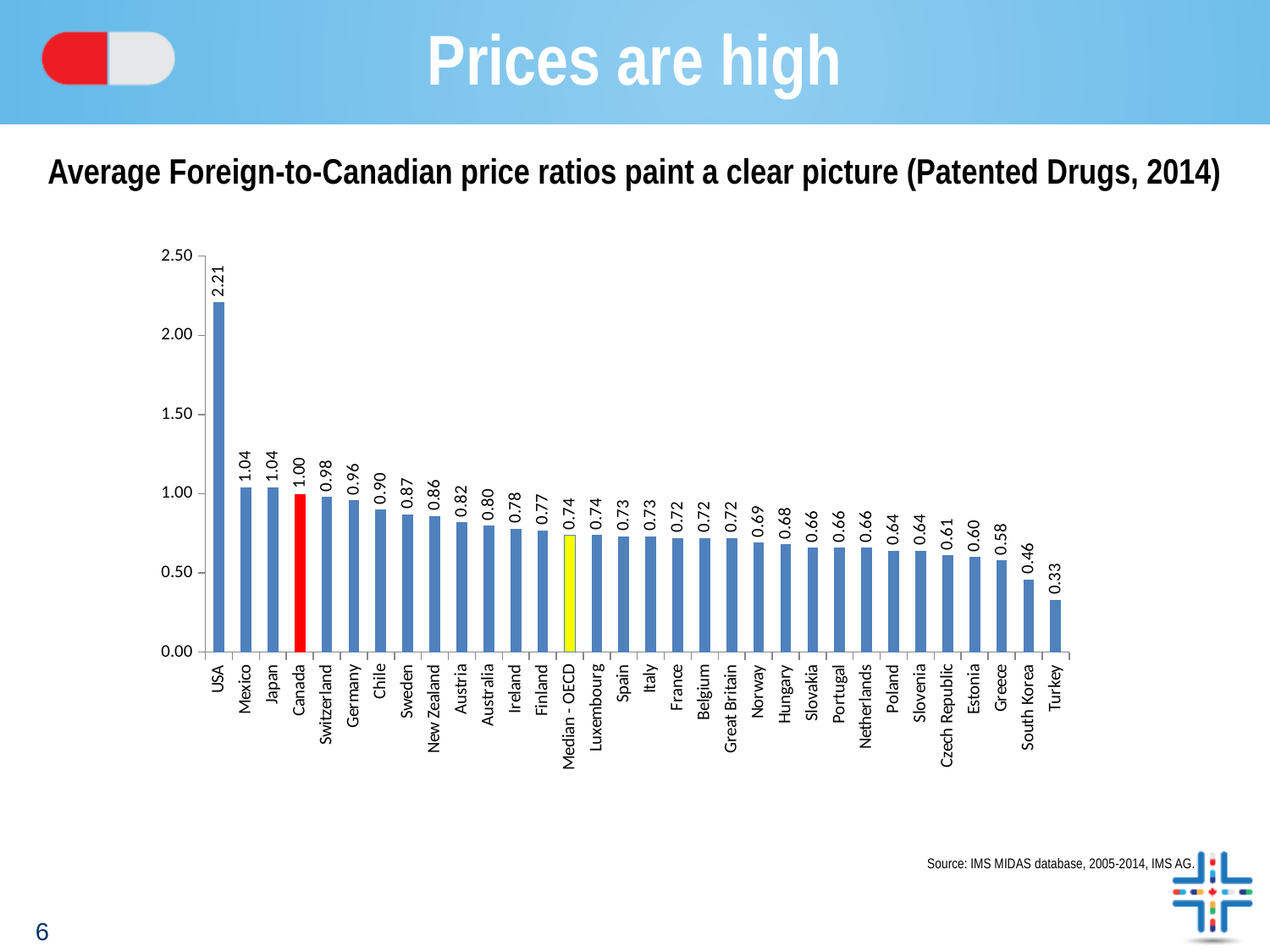
Which category has the lowest value? Turkey What kind of chart is shown on the slide? bar chart How many categories are shown on the x axis? 32 What is the value for Median - OECD? 0.74 Which is larger, the value for Germany or the value for Greece? Germany What is the difference between the values for the USA and Canada? 1.21 What is the value for Canada? 1.00 What is the value for Turkey? 0.33 Which category has the highest value? USA Which bar is coloured red? Canada What is the value for the USA? 2.21 Is the value for South Korea greater or less than 0.50? less